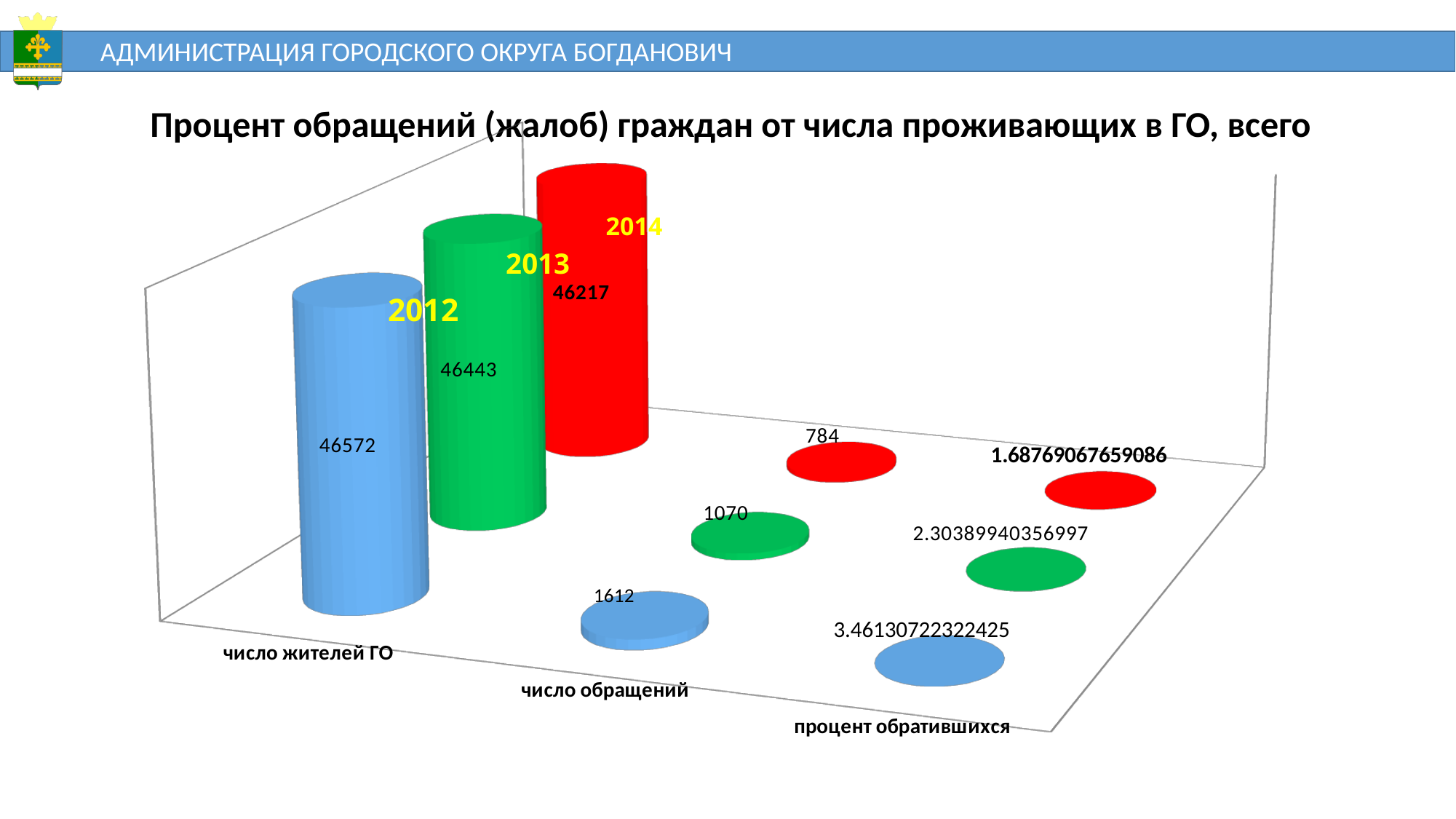
What is the value for число обращений in 2014? 784 How many years (series) are shown in the chart? 3 How many categories are shown along the x axis? 3 What is the difference between число обращений in 2012 and in 2014? 828 What is the value for число жителей ГО in 2012? 46572 Which year has the highest value for число обращений? 2012 What is the difference between число жителей ГО in 2012 and in 2013? 129 What is the value for число обращений in 2013? 1070 What is the value for процент обратившихся in 2013? 2.30389940356997 Does число обращений rise or fall from 2012 to 2014? fall Which is larger: число обращений in 2013 or in 2014? 2013 Which year has the lowest value for процент обратившихся? 2014